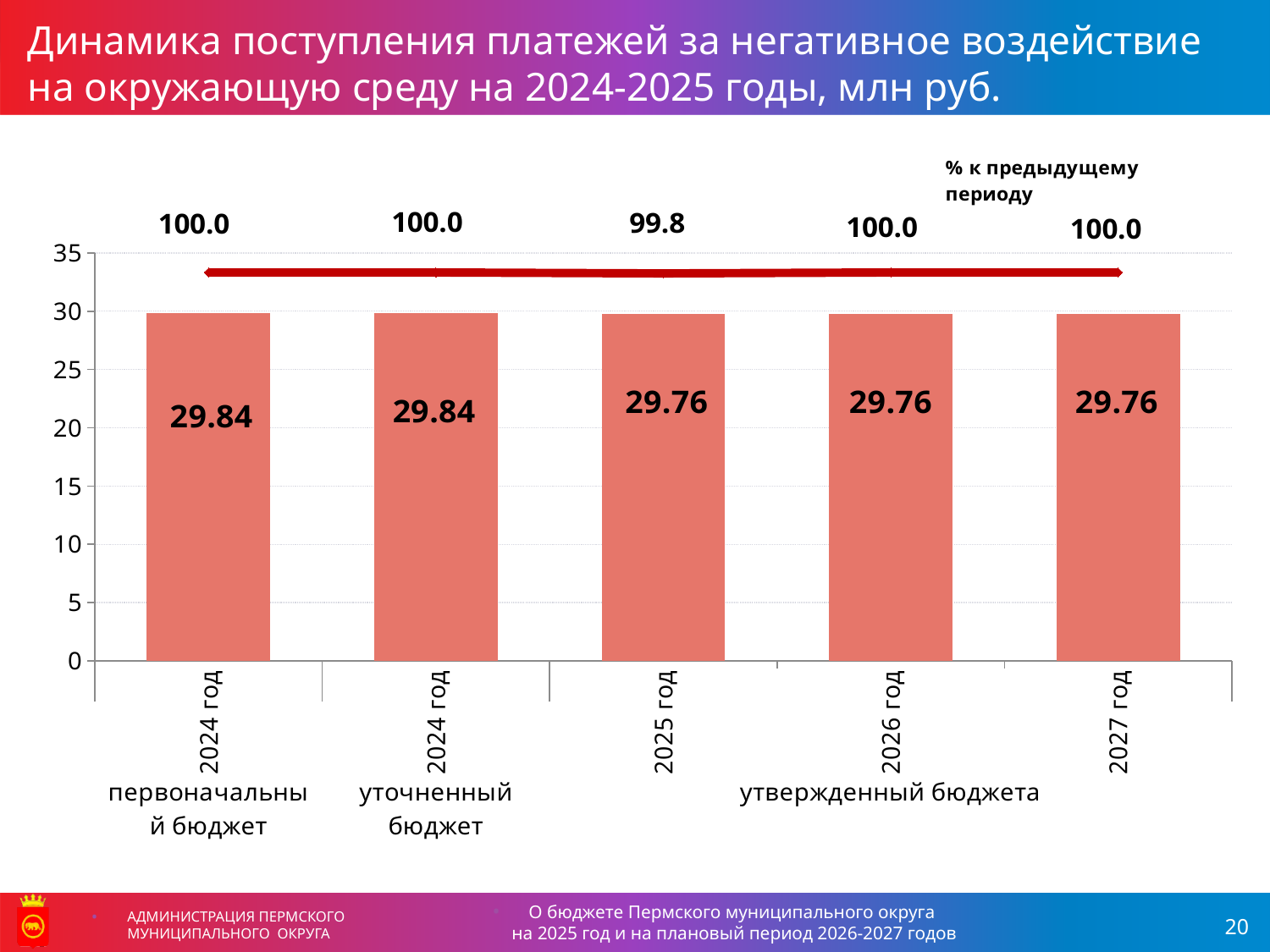
Which is larger: the value for 2024 год (уточненный бюджет) or the value for 2026 год? 2024 год (уточненный бюджет) What is the value for 2027 год? 29.76 What is the '% к предыдущему периоду' value shown above the 2025 год bar? 99.8 What is the value for 2025 год? 29.76 What kind of chart is shown on the slide? combination bar and line chart Is the value for 2027 год greater or less than 30? less What is the value for 2024 год (первоначальный бюджет)? 29.84 How many bars are plotted in the chart? 5 Do the bar values rise or fall from 2024 год (уточненный бюджет) to 2025 год? fall What is the difference between the value for 2024 год (уточненный бюджет) and the value for 2025 год? 0.08 What is the unit of measurement stated in the chart title? млн руб. Is the value for 2026 год greater or less than 25? greater